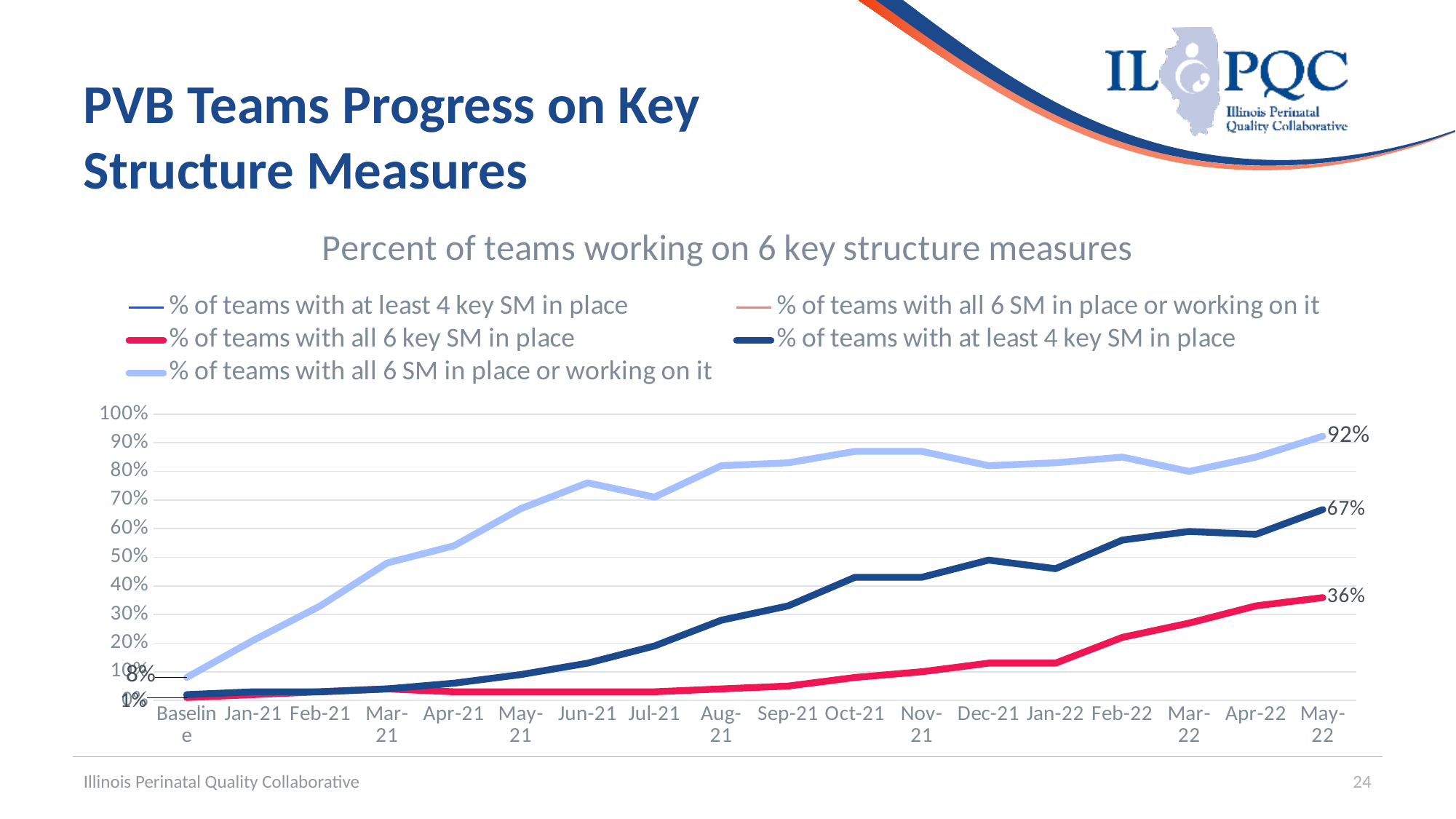
At May-22, which is larger: '% of teams with at least 4 key SM in place' or '% of teams with all 6 key SM in place'? % of teams with at least 4 key SM in place What is the value for '% of teams with all 6 SM in place or working on it' at May-22? 92% Is the value for '% of teams with all 6 SM in place or working on it' at Oct-21 greater or less than 80%? greater What is the value for '% of teams with all 6 key SM in place' at May-22? 36% What is the value for '% of teams with all 6 SM in place or working on it' at Baseline? 8% What is the value for '% of teams with at least 4 key SM in place' at May-22? 67% At May-22, what is the difference between '% of teams with all 6 SM in place or working on it' and '% of teams with at least 4 key SM in place'? 25 percentage points Is the value for '% of teams with at least 4 key SM in place' at Jan-22 greater or less than 50%? less How many time points are shown on the x axis, including Baseline? 18 What kind of chart is shown on the slide? line chart At May-22, what is the difference between '% of teams with at least 4 key SM in place' and '% of teams with all 6 key SM in place'? 31 percentage points What is the chart's title? Percent of teams working on 6 key structure measures